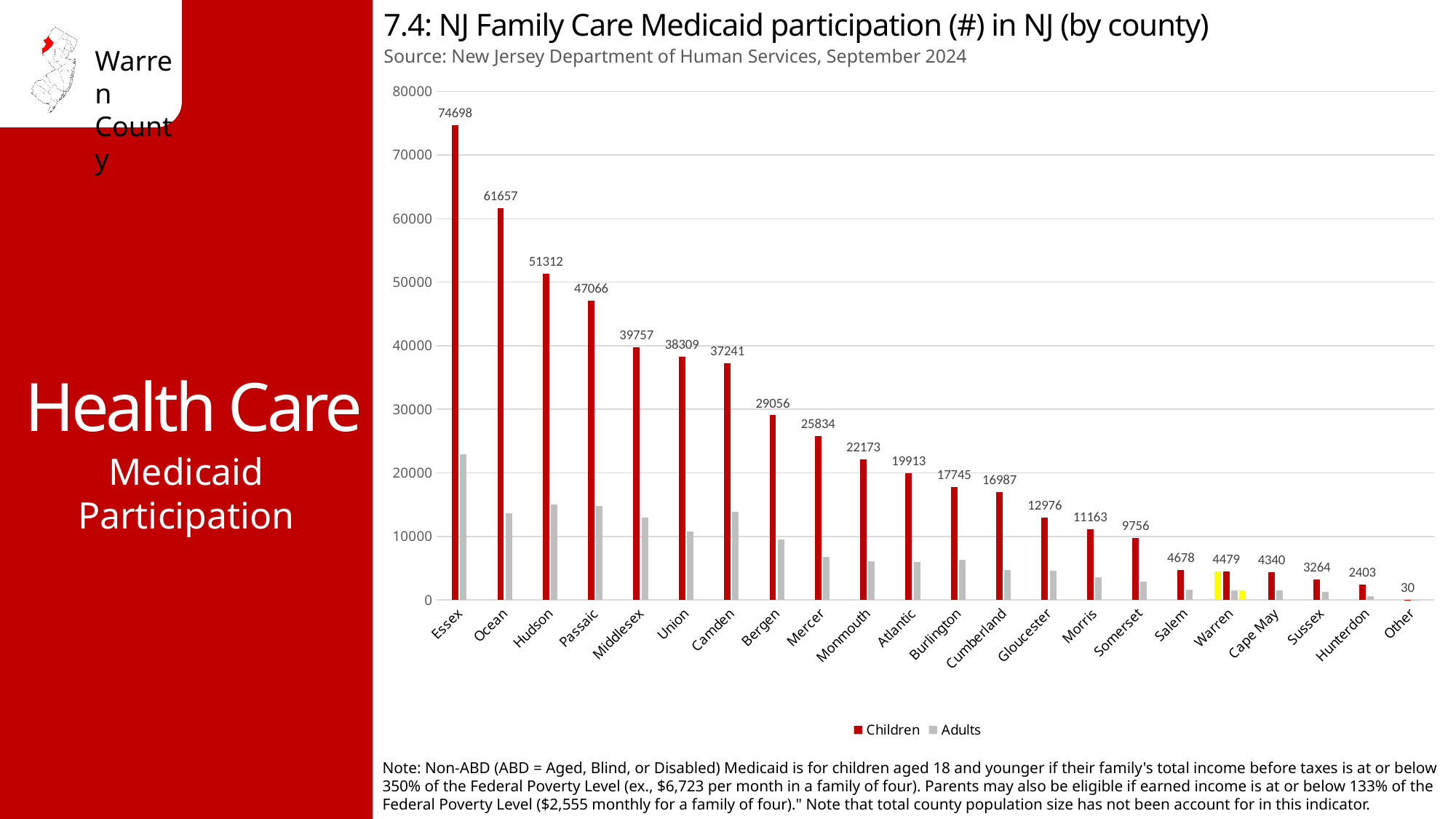
Is the Adults value for Ocean greater or less than 20000? less Which has a larger Children value, Bergen or Mercer? Bergen How many series does the legend list? 2 Which category has the lowest Children value? Other What is the Children value for Monmouth? 22173 What is the Children value for Warren? 4479 Is the Adults value for Essex greater or less than 20000? greater How many categories are shown on the x axis? 22 What is the Children value for Essex? 74698 Which county has the highest Children value? Essex What is the difference between the Children values for Ocean and Hudson? 10345 What kind of chart is shown on the slide? Bar chart